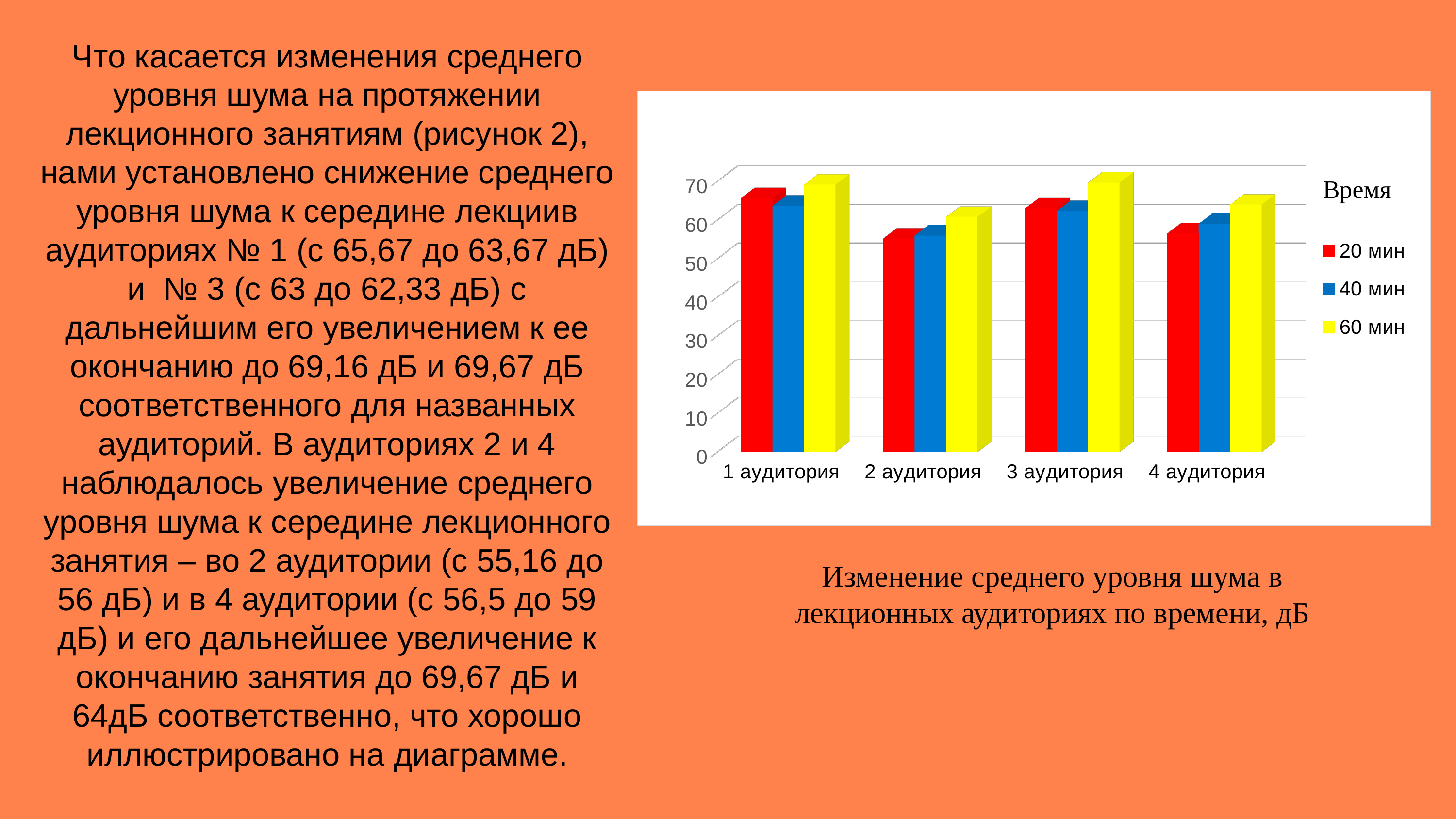
What is the title of the chart's legend? Время Is the value for 20 мин in 4 аудитория greater or less than 60? less Which is larger: the 20 мин value for 1 аудитория or the 20 мин value for 2 аудитория? 1 аудитория In 3 аудитория, which is larger: the 40 мин value or the 60 мин value? 60 мин How many series does the chart's legend list? 3 Which colour represents the 60 мин series in the chart? yellow Is the value for 20 мин in 1 аудитория greater or less than 60? greater Is the value for 20 мин in 2 аудитория greater or less than 60? less In 2 аудитория, which is larger: the 20 мин value or the 60 мин value? 60 мин How many categories (аудитории) are shown on the x axis of the chart? 4 What kind of chart is shown on the slide? bar chart